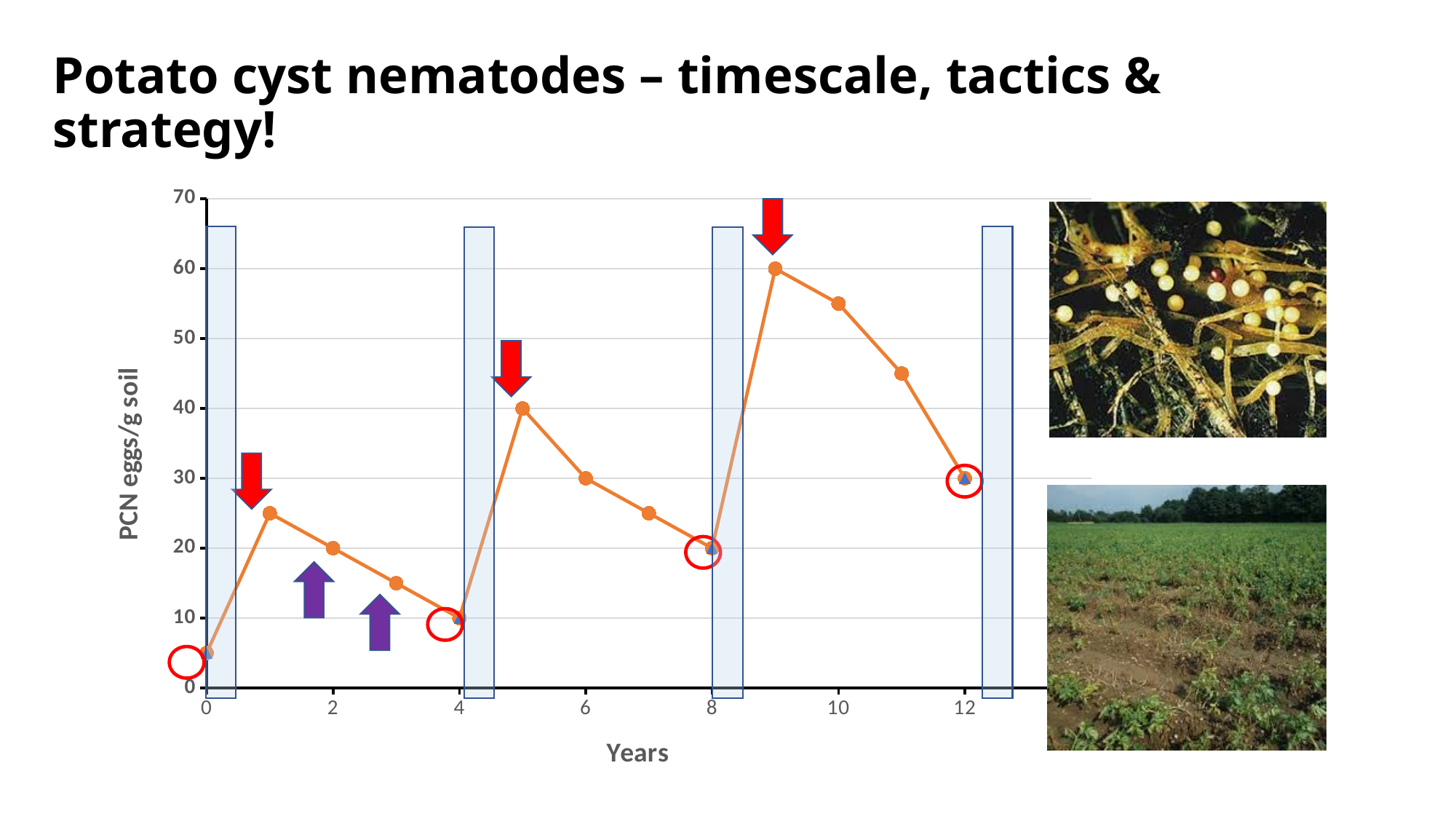
What is the difference between the value at year 9 and the value at year 5? 20 Is the value at year 1 greater or less than 20? greater What kind of chart is shown on the slide? line chart What is the PCN eggs/g soil value at year 8? 20 Do the values rise or fall between year 9 and year 12? fall What is the label on the vertical axis of the chart? PCN eggs/g soil Is the value at year 10 greater or less than 50? greater Which year has the larger value, year 5 or year 9? year 9 At which year does the PCN eggs/g soil value reach its highest point? 9 Is the value at year 3 greater or less than 20? less What is the PCN eggs/g soil value at year 5? 40 What is the PCN eggs/g soil value at year 9? 60